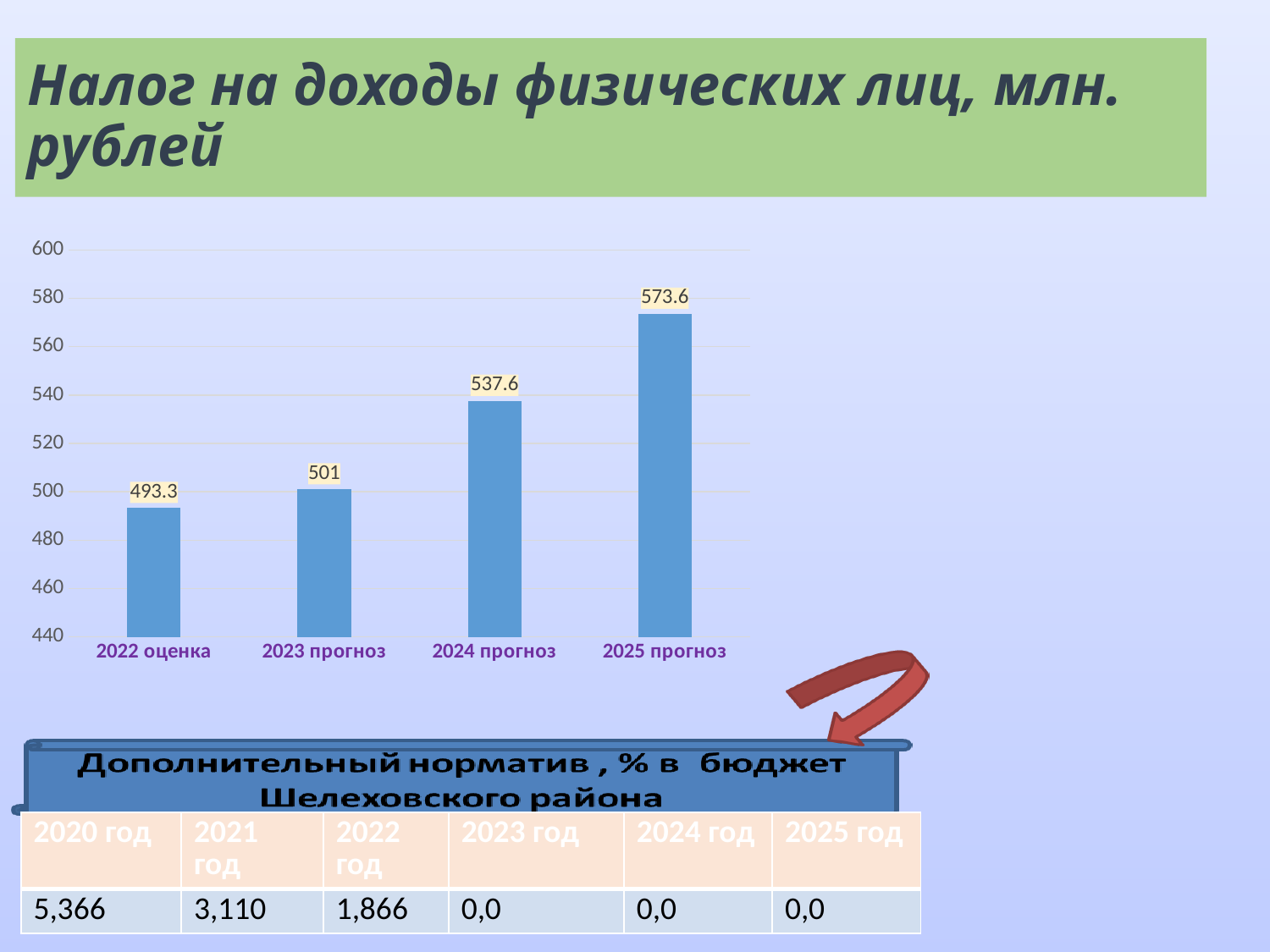
Which category has the lowest value? 2022 оценка What is the value for 2025 прогноз? 573.6 What kind of chart is shown on the slide? bar chart What is the value for 2022 оценка? 493.3 What is the value for 2024 прогноз? 537.6 Which is larger, the value for 2023 прогноз or the value for 2024 прогноз? 2024 прогноз Is the value for 2025 прогноз greater or less than 560? greater What is the difference between the values for 2023 прогноз and 2022 оценка? 7.7 How many bars are shown in the chart? 4 What is the difference between the values for 2025 прогноз and 2024 прогноз? 36 Do the values rise or fall from 2022 оценка to 2025 прогноз? rise Which category has the highest value? 2025 прогноз